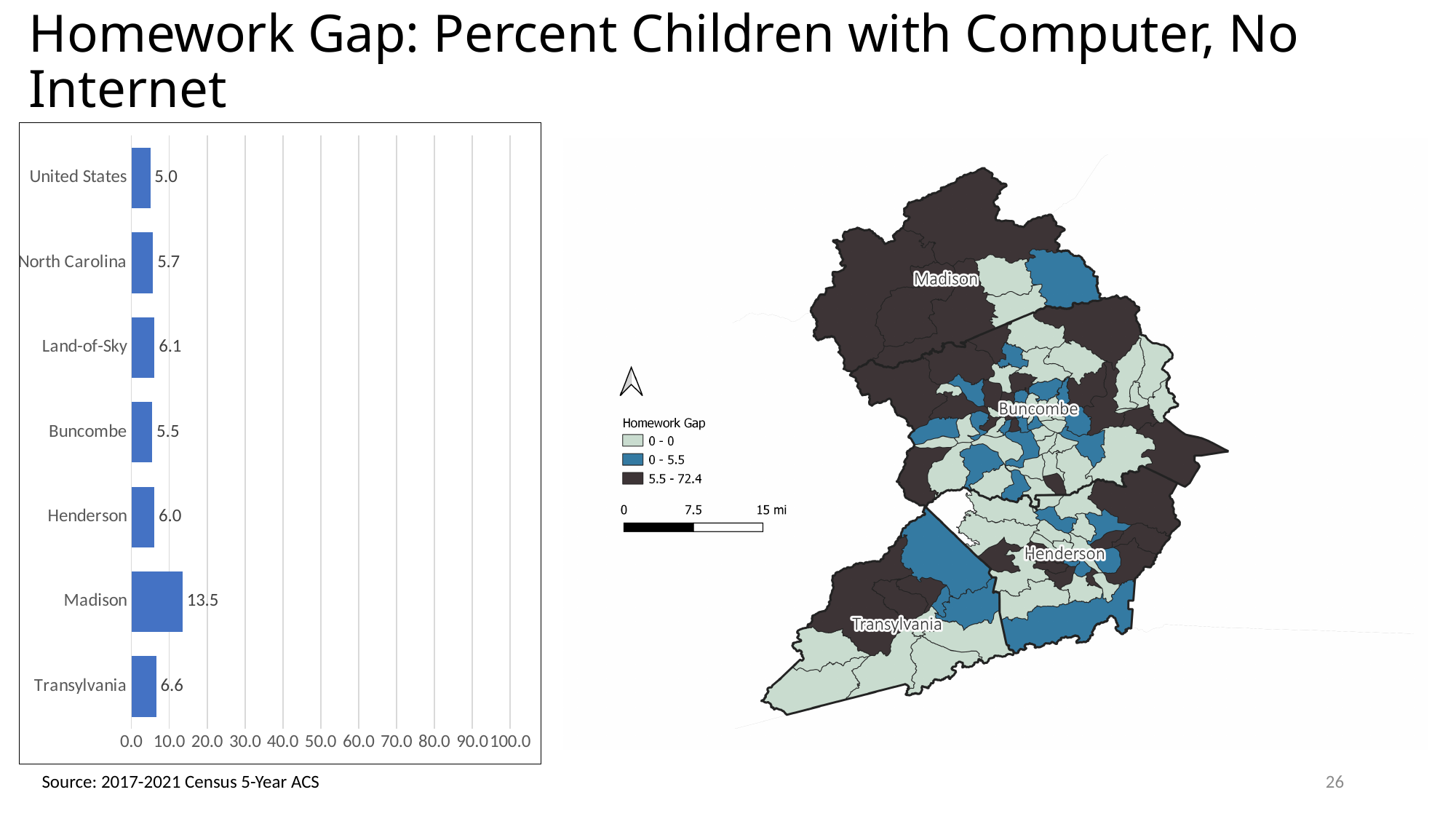
What is the difference between the values for Madison and Buncombe in the bar chart? 8.0 What is the highest value on the x axis of the bar chart? 100.0 What is the value for United States in the bar chart? 5.0 What is the value for Madison in the bar chart? 13.5 Which category has the highest value in the bar chart? Madison What kind of chart is shown on the left of the slide? bar chart What is the value for Land-of-Sky in the bar chart? 6.1 What is the value for Transylvania in the bar chart? 6.6 Is the value for Madison in the bar chart greater or less than 10.0? greater Which is larger in the bar chart, the value for North Carolina or the value for Henderson? Henderson How many categories are shown in the bar chart? 7 Which category has the lowest value in the bar chart? United States